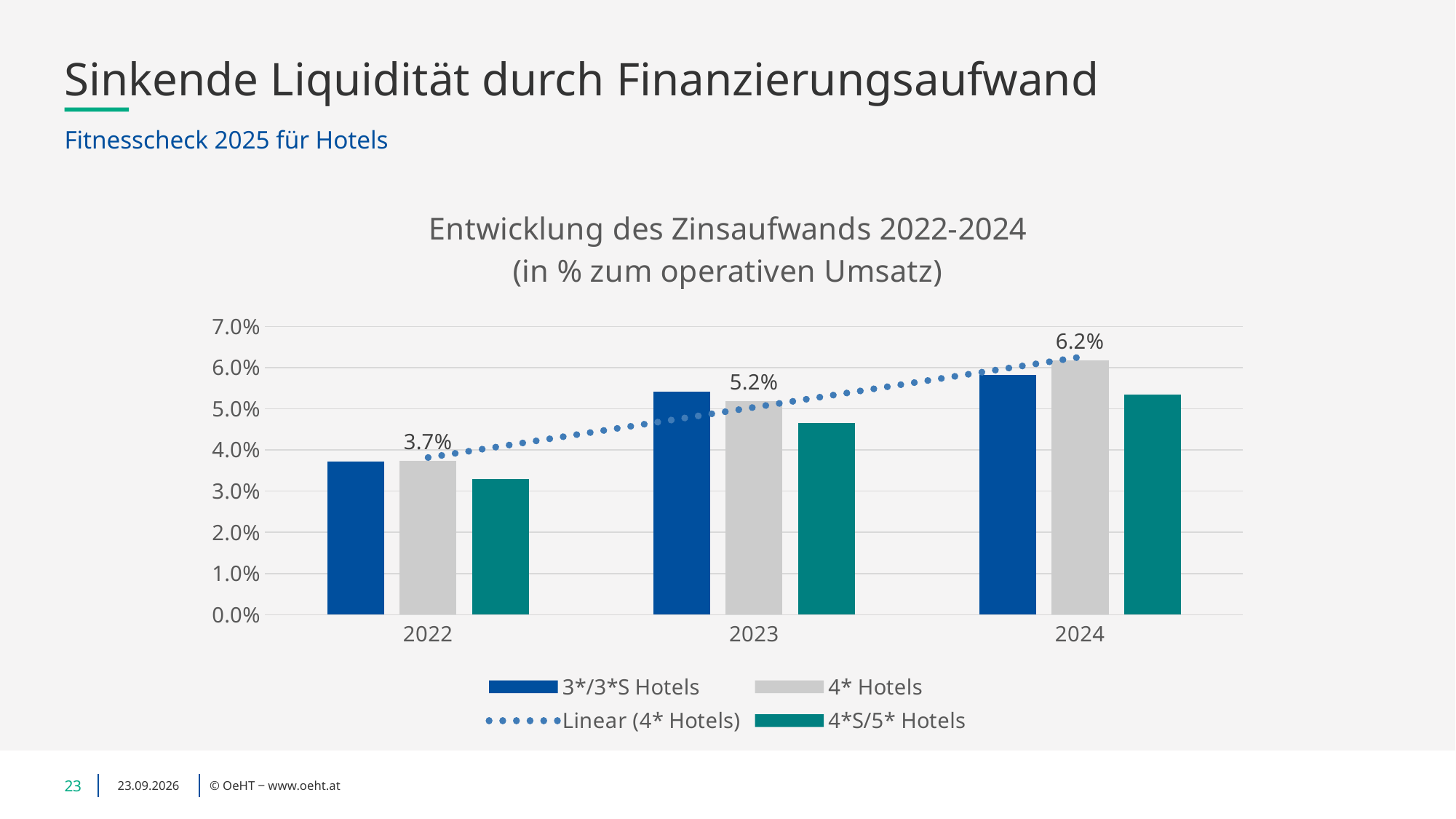
How many entries does the legend list? 4 By how many percentage points did the value for 4* Hotels increase from 2022 to 2024? 2.5 percentage points What is the value for 4* Hotels in 2023? 5.2% Does the value for 4* Hotels rise or fall from 2022 to 2024? rise Is the value for 4*S/5* Hotels in 2024 greater or less than 5.0%? greater What is the value for 4* Hotels in 2024? 6.2% What is the value for 4* Hotels in 2022? 3.7% Which hotel category has the lowest value in 2023? 4*S/5* Hotels What type of chart is shown on the slide? bar chart How many years are shown on the x axis? 3 Is the value for 3*/3*S Hotels in 2022 greater or less than 4.0%? less Which hotel category has the highest value in 2024? 4* Hotels